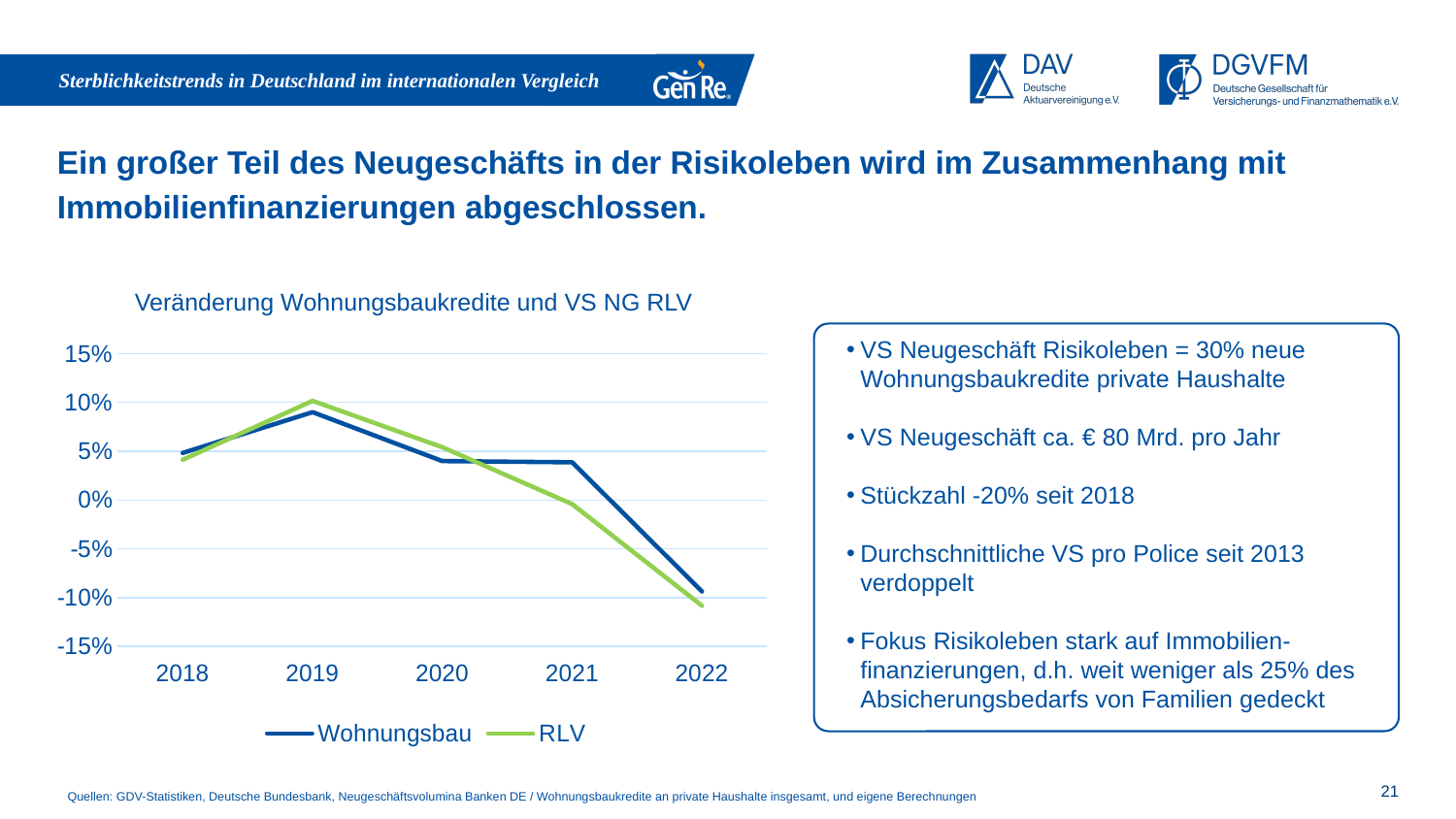
In which year does the RLV series reach its highest value? 2019 In 2021, which series has the higher value, Wohnungsbau or RLV? Wohnungsbau Is the value for RLV in 2019 greater or less than 5%? greater How many years are shown on the x axis of the chart? 5 Is the value for RLV in 2021 greater or less than 5%? less Is the value for Wohnungsbau in 2022 greater or less than -5%? less How many series does the chart legend list? 2 What kind of chart is shown on the slide? line chart In which year does the Wohnungsbau series reach its lowest value? 2022 Which series is drawn in green in the chart? RLV What is the title of the chart? Veränderung Wohnungsbaukredite und VS NG RLV Do the values of the RLV series rise or fall from 2019 to 2022? fall